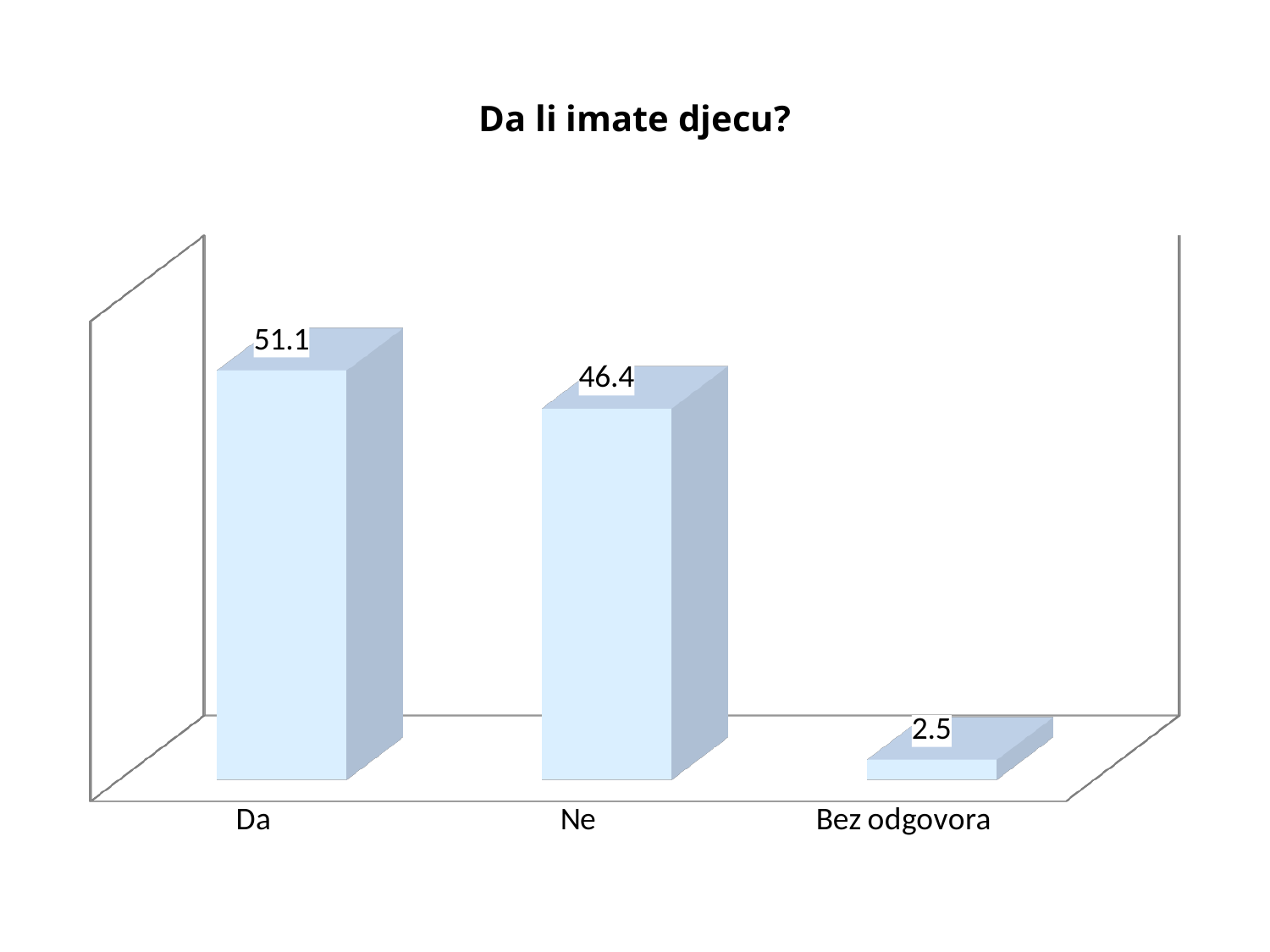
What kind of chart is shown on the slide? Bar chart What is the value for "Da"? 51.1 What is the value for "Ne"? 46.4 What is the value for "Bez odgovora"? 2.5 What is the title of the chart? Da li imate djecu? What is the difference between the values for "Ne" and "Bez odgovora"? 43.9 Which category has the highest value? Da What is the difference between the values for "Da" and "Ne"? 4.7 Do the values rise or fall from left to right along the x axis? Fall How many categories are shown on the chart? 3 Which is larger, the value for "Da" or the value for "Ne"? Da Which category has the lowest value? Bez odgovora